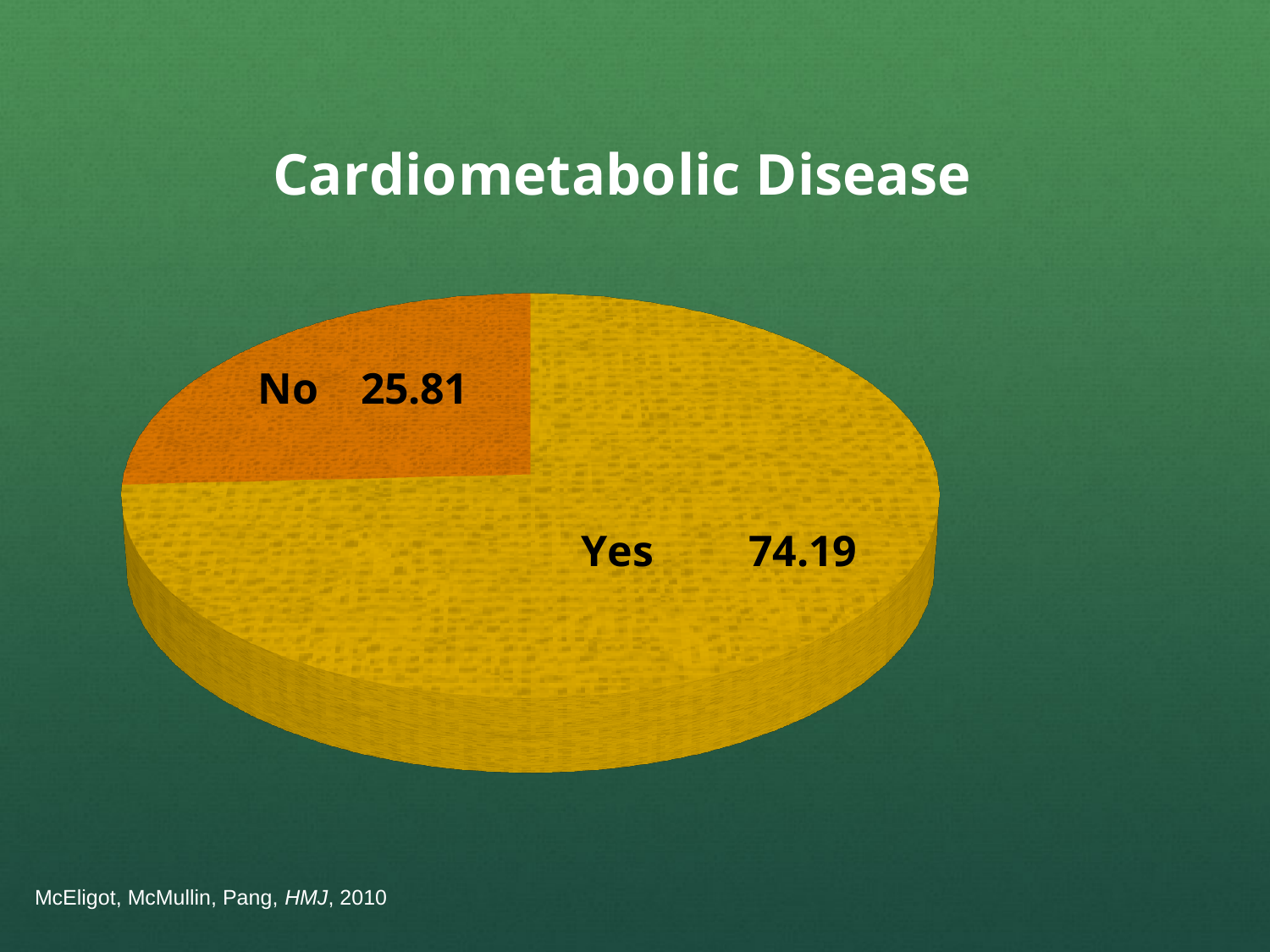
Which slice of the pie chart is the largest? Yes What is the value for the "No" slice in the Cardiometabolic Disease pie chart? 25.81 What is the total of the two slice values shown in the pie chart? 100 How many slices does the pie chart have? 2 Which is larger in the pie chart, the "Yes" slice or the "No" slice? Yes What is the value for the "Yes" slice in the Cardiometabolic Disease pie chart? 74.19 What is the difference between the "Yes" and "No" values in the pie chart? 48.38 What kind of chart is shown on the slide? Pie chart Which slice of the pie chart is the smallest? No What is the title of the chart on the slide? Cardiometabolic Disease What colour is the "No" slice in the pie chart? Orange